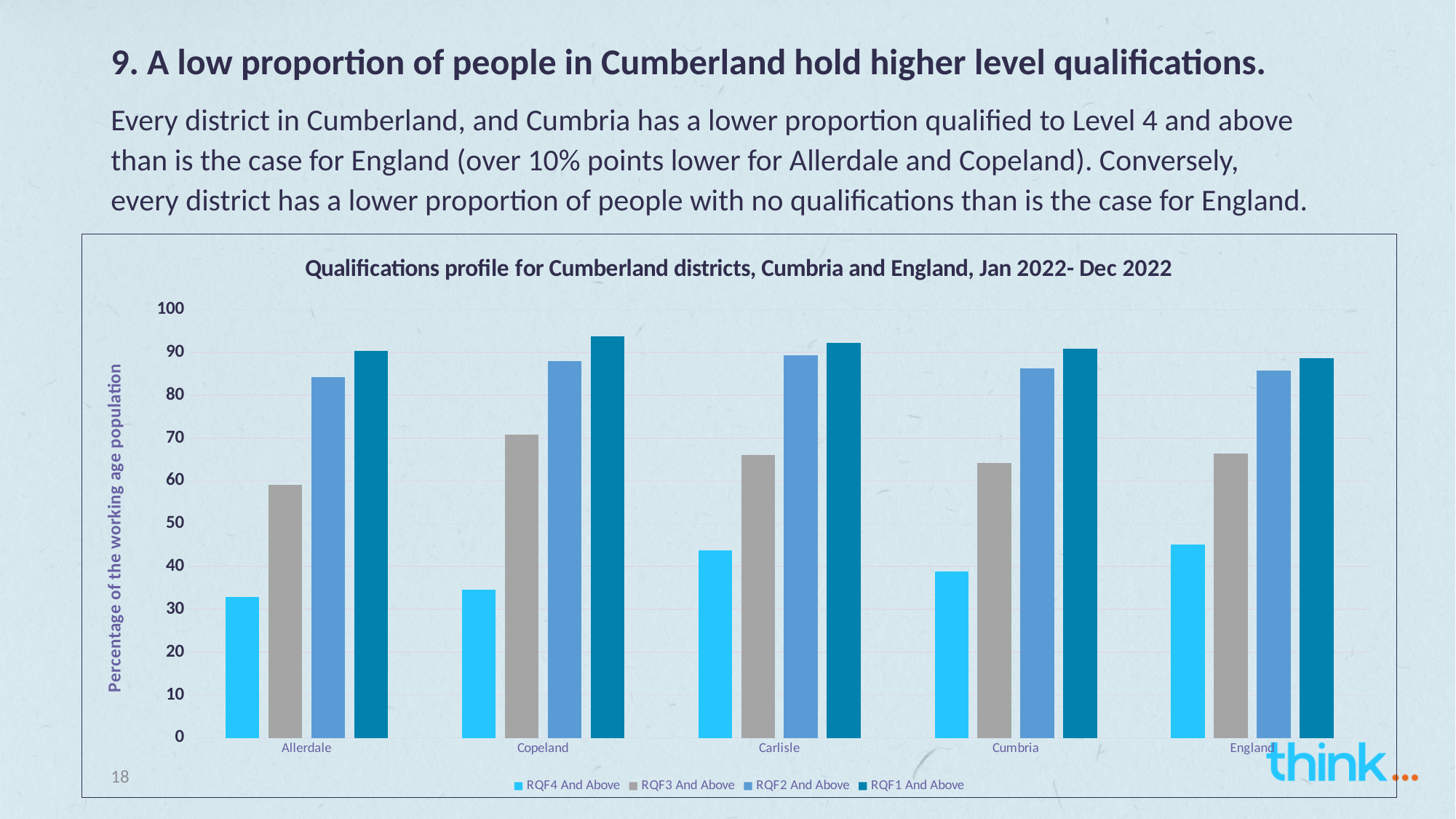
How many series does the legend list? 4 What kind of chart is shown on the slide? bar chart What is the label on the vertical axis of the chart? Percentage of the working age population Which is larger: the RQF4 And Above value for England or for Cumbria? England Which area has the highest value for RQF1 And Above? Copeland Is the value for RQF4 And Above in England greater or less than 40? greater Which area has the lowest value for RQF3 And Above? Allerdale Is the value for RQF1 And Above in Copeland greater or less than 90? greater Which is larger: the RQF4 And Above value for Carlisle or for Allerdale? Carlisle Is the value for RQF4 And Above in Allerdale greater or less than 40? less How many areas (categories) are shown on the x axis? 5 Which area has the highest value for RQF3 And Above? Copeland